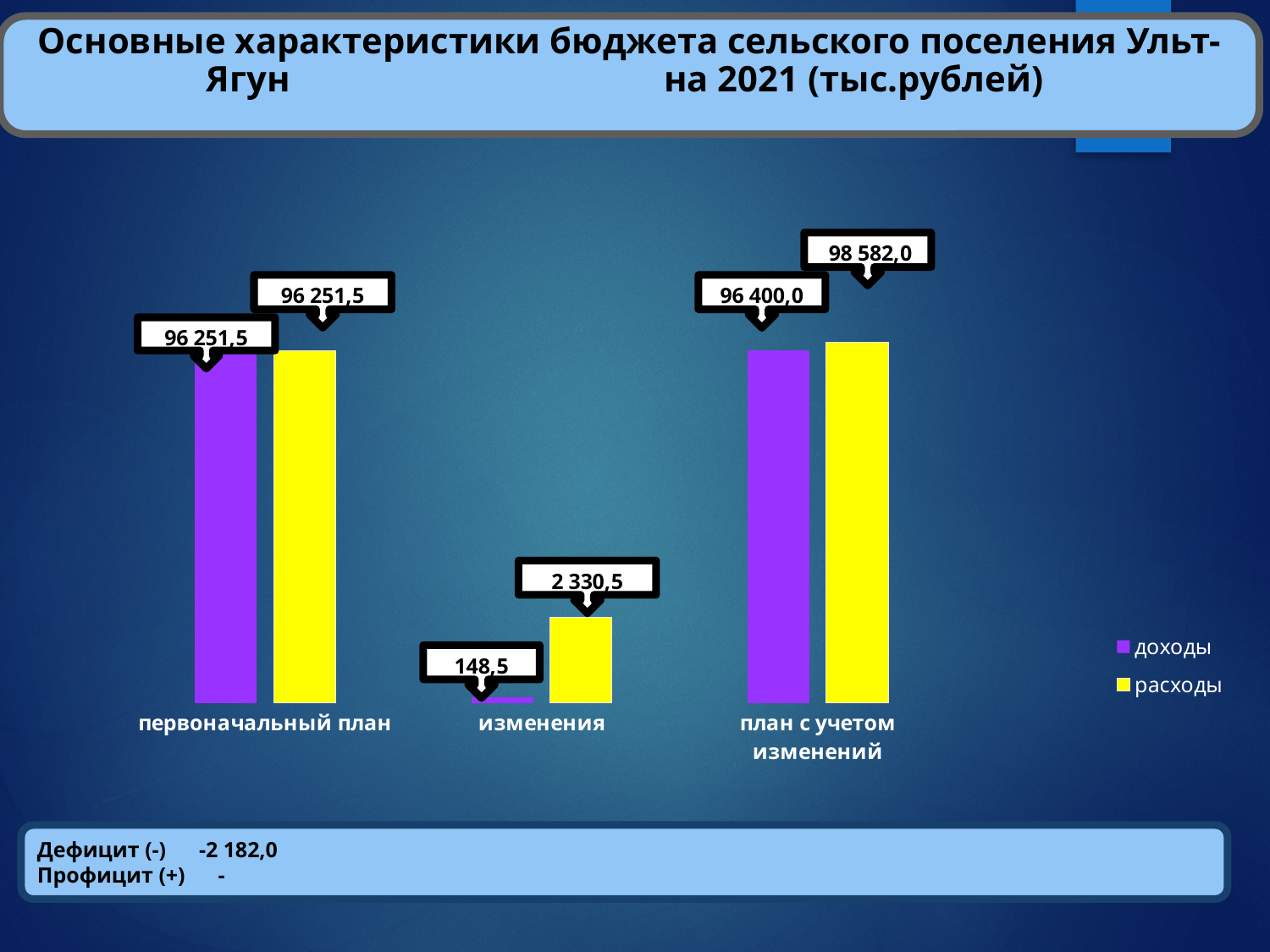
What is the value of доходы for изменения? 148,5 Which is larger for изменения: доходы or расходы? расходы Which category has the highest value for расходы? план с учетом изменений How many series does the legend list? 2 What is the difference between расходы and доходы for изменения? 2 182,0 What is the value of доходы for первоначальный план? 96 251,5 How many categories are shown on the x axis? 3 What is the value of расходы for изменения? 2 330,5 What is the value of доходы for план с учетом изменений? 96 400,0 What is the value of расходы for план с учетом изменений? 98 582,0 Which category has the lowest value for доходы? изменения What is the difference between расходы and доходы for план с учетом изменений? 2 182,0